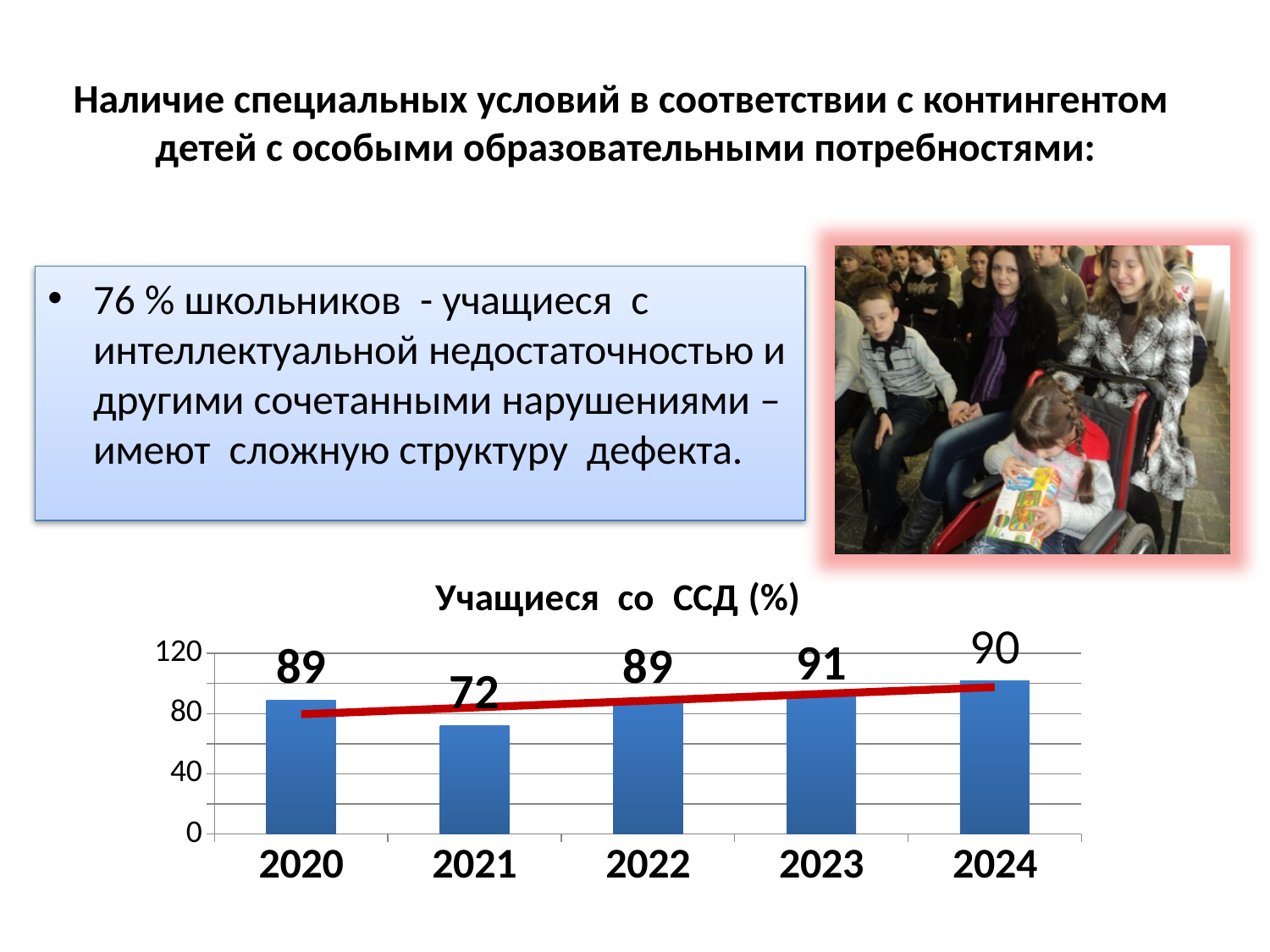
How many years are shown on the x axis of the chart? 5 Which is larger, the value for 2020 or the value for 2021? 2020 What is the value for 2022 in the chart? 89 What is the value for 2020 in the chart? 89 What is the title of the chart on the slide? Учащиеся со ССД (%) What is the value for 2023 in the chart? 91 What is the value for 2021 in the chart 'Учащиеся со ССД (%)'? 72 What kind of chart is shown on the slide? bar chart What is the difference between the values for 2020 and 2021? 17 What is the difference between the values for 2023 and 2021? 19 Which year has the lowest value in the chart? 2021 Is the value for 2021 greater or less than 80? less